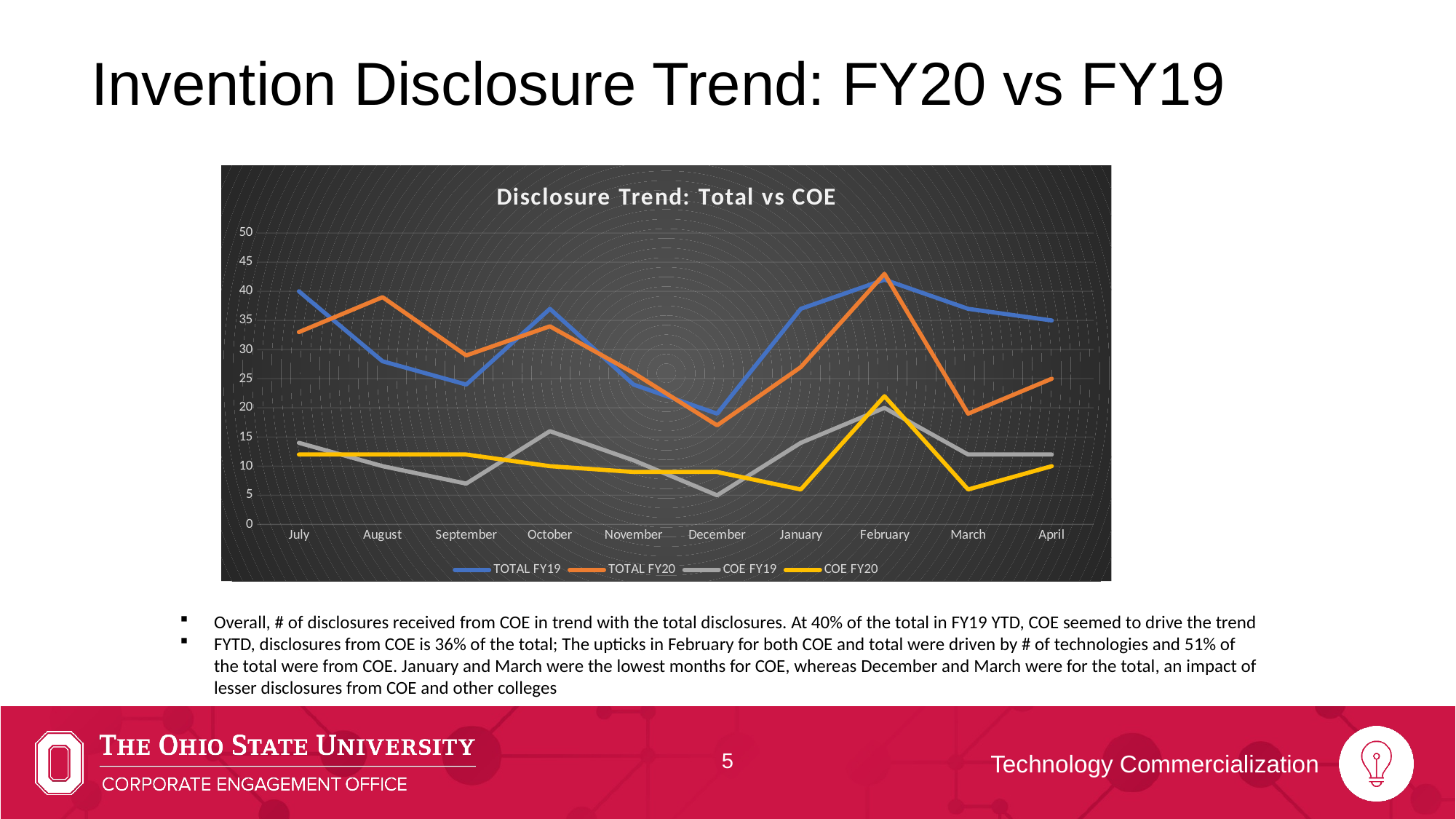
How many months are plotted along the x axis? 10 In which month is COE FY19 at its lowest value? December Is the TOTAL FY20 value for February greater or less than 40? greater In August, which is larger: TOTAL FY19 or TOTAL FY20? TOTAL FY20 In which month does TOTAL FY20 reach its highest value? February How many series does the chart legend list? 4 What is the TOTAL FY19 value for July? 40 In July, which is larger: TOTAL FY19 or TOTAL FY20? TOTAL FY19 What is the COE FY19 value for December? 5 What is the title of the chart? Disclosure Trend: Total vs COE Which colour is used for the COE FY20 line? Yellow What type of chart is shown on the slide? Line chart